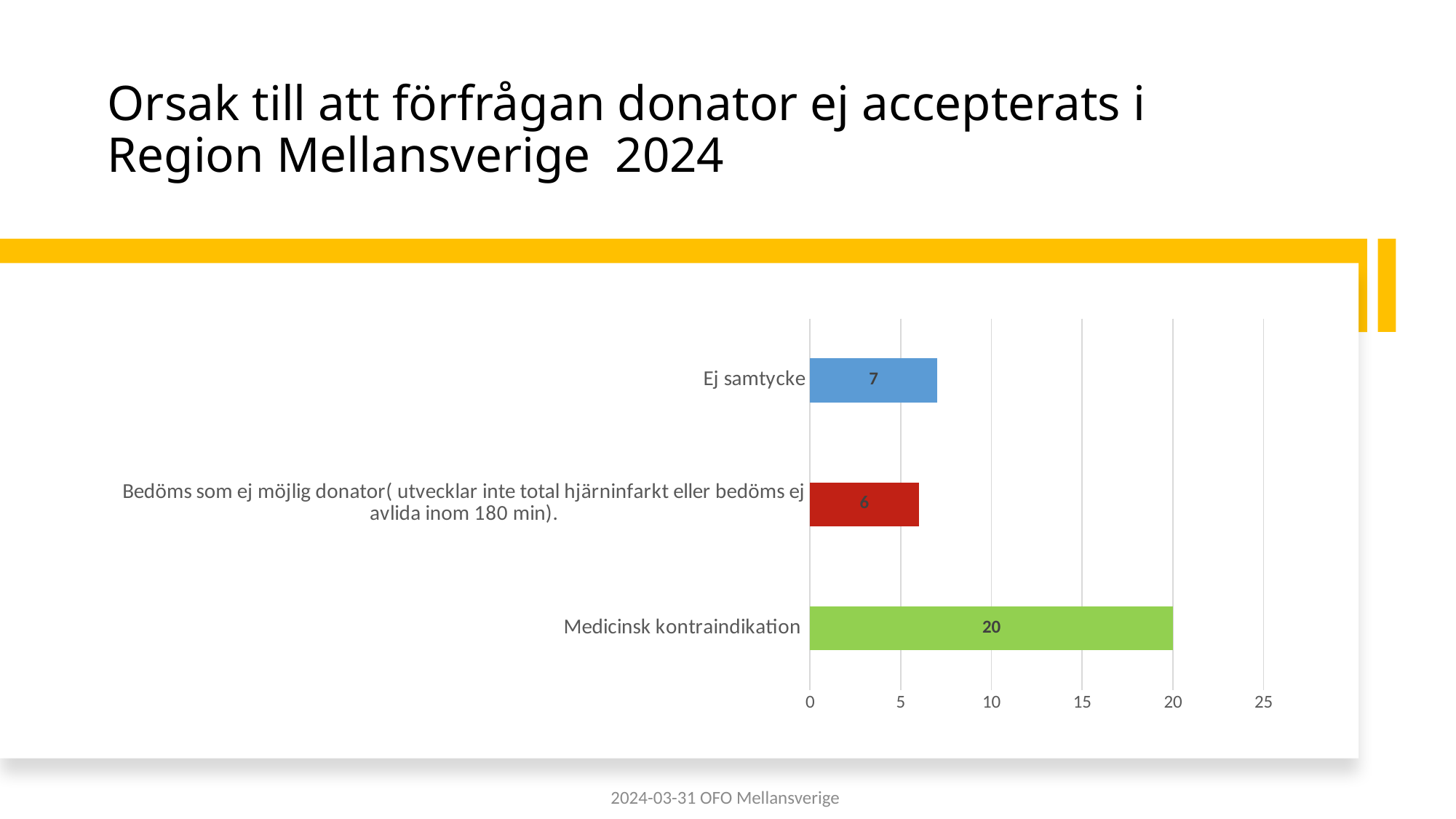
How many categories are shown in the chart? 3 Which is larger, the value for Ej samtycke or the value for Bedöms som ej möjlig donator? Ej samtycke What is the value for the category 'Bedöms som ej möjlig donator'? 6 What is the difference between the values for Medicinsk kontraindikation and Ej samtycke? 13 Which category has the highest value? Medicinsk kontraindikation Which category has the lowest value? Bedöms som ej möjlig donator( utvecklar inte total hjärninfarkt eller bedöms ej avlida inom 180 min). What is the total of the three values shown in the chart? 33 What kind of chart is shown on the slide? Bar chart Is the value for Medicinsk kontraindikation greater or less than 15? greater What is the value for Ej samtycke? 7 What colour is the bar for Medicinsk kontraindikation? Green What is the value for Medicinsk kontraindikation? 20